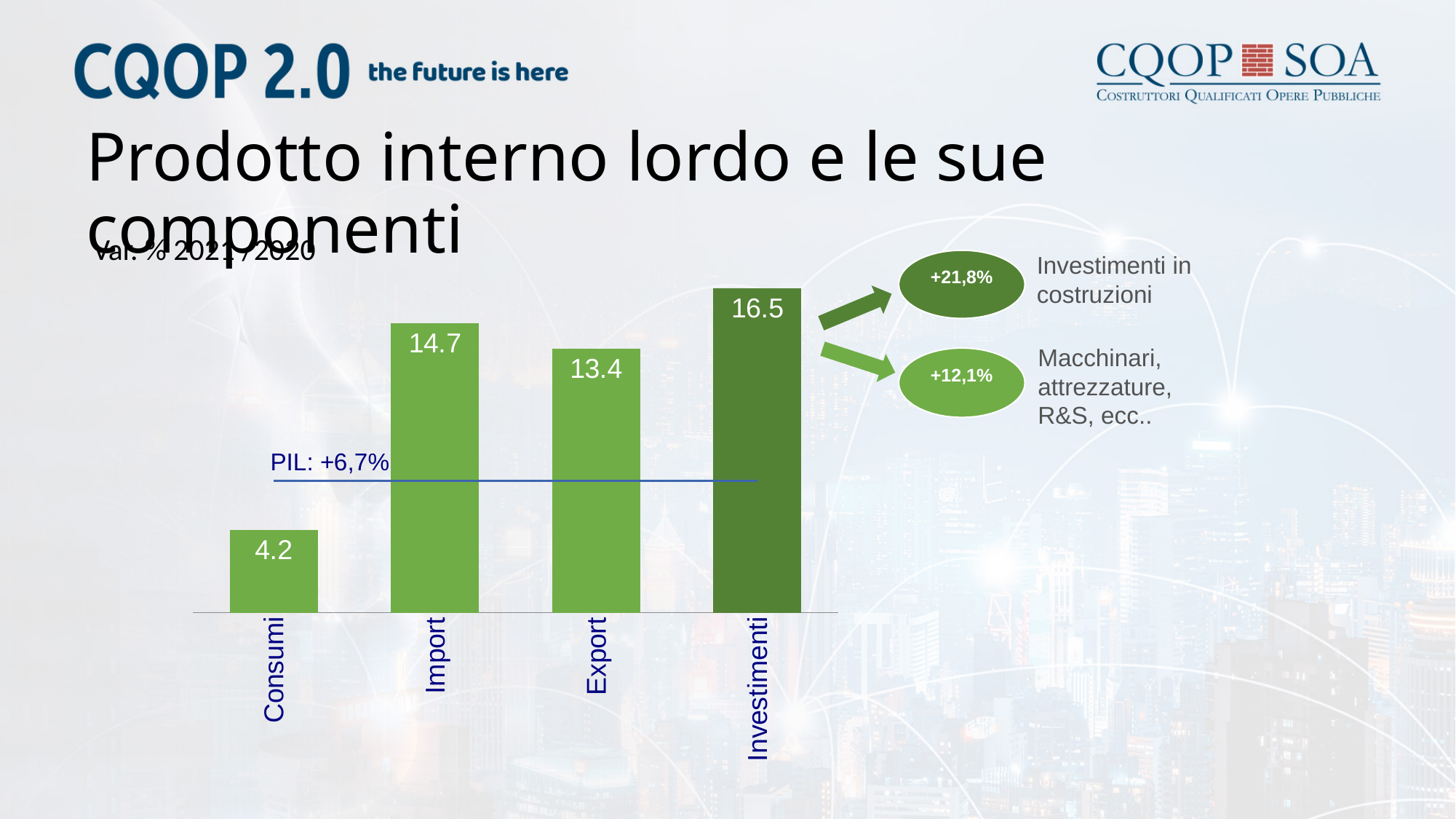
What is the value for Consumi? 4.2 What is the value for Investimenti? 16.5 What PIL value is shown by the horizontal reference line on the chart? +6,7% How many categories are shown in the bar chart? 4 What kind of chart is shown on the slide? Bar chart Which is larger, the value for Import or the value for Export? Import What is the difference between the values for Import and Export? 1.3 Which category has the lowest value? Consumi What is the value for Export? 13.4 What is the value for Import? 14.7 Which category has the highest value? Investimenti What is the difference between the values for Investimenti and Consumi? 12.3